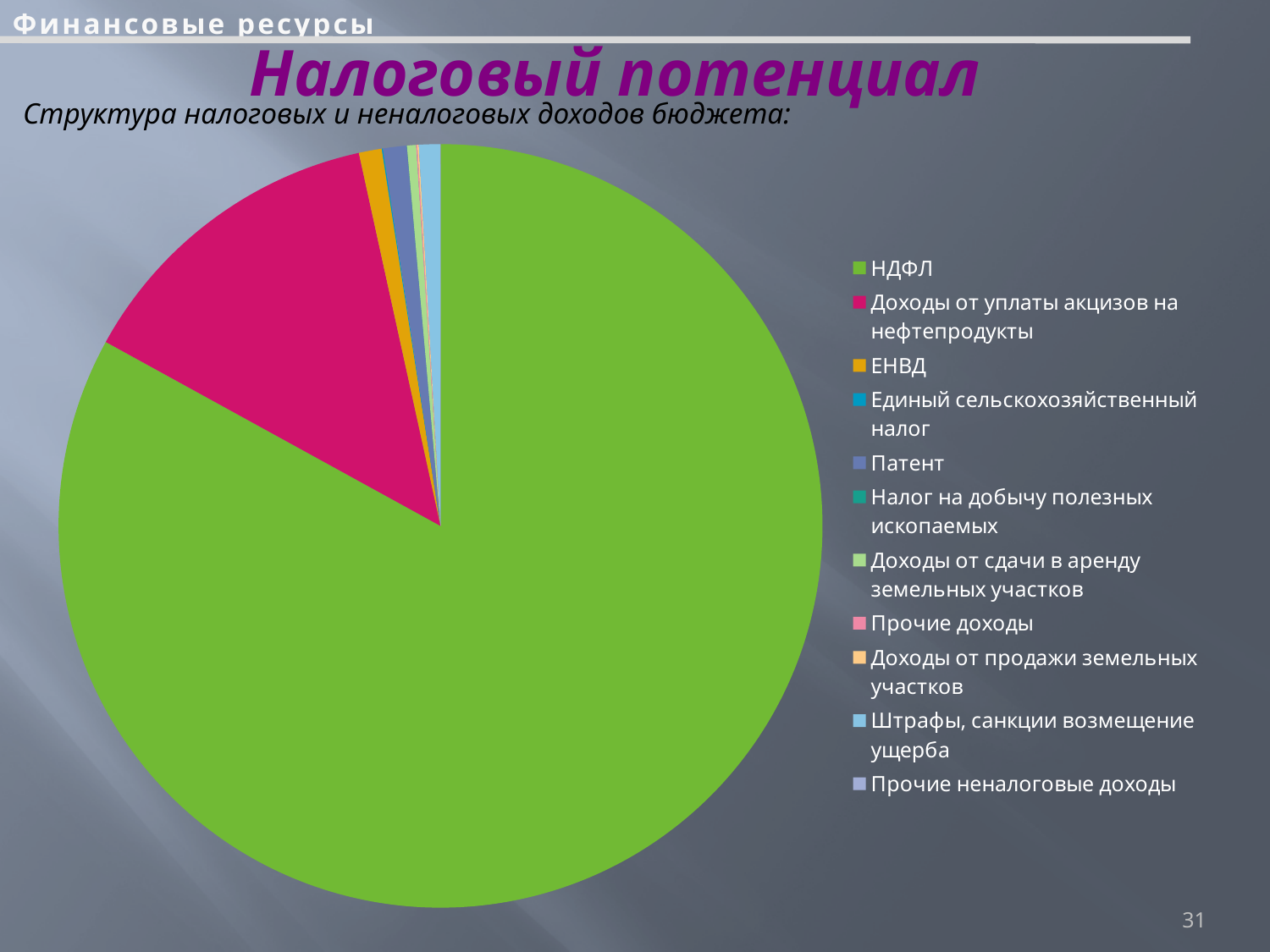
Which is larger: the slice for ЕНВД or the slice for НДФЛ? НДФЛ Which is larger: the slice for Доходы от уплаты акцизов на нефтепродукты or the slice for Патент? Доходы от уплаты акцизов на нефтепродукты What is the subtitle describing the pie chart on the slide? Структура налоговых и неналоговых доходов бюджета: How many categories does the legend of the pie chart list? 11 Which category has the largest slice of the pie chart? НДФЛ What colour is the slice for НДФЛ in the pie chart? green Which is larger: the slice for НДФЛ or the slice for Доходы от уплаты акцизов на нефтепродукты? НДФЛ Which category has the second-largest slice of the pie chart? Доходы от уплаты акцизов на нефтепродукты What kind of chart is shown on the slide? pie chart